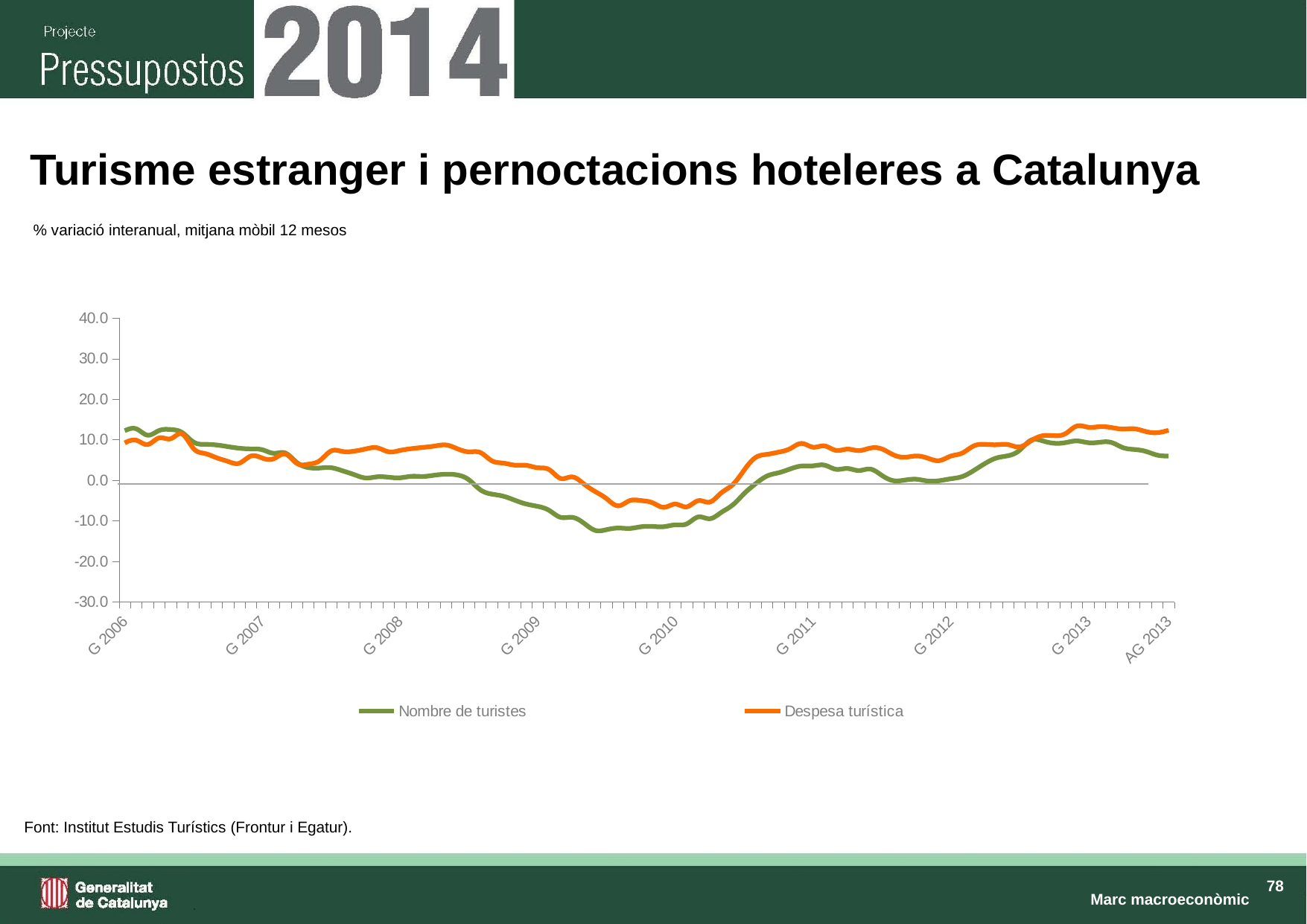
What kind of chart is shown on the slide? line chart Is the value for Despesa turística at G 2010 greater or less than 0.0? less How many series does the legend list? 2 What are the two series named in the legend? Nombre de turistes and Despesa turística Which series reaches the lowest value on the chart? Nombre de turistes At G 2006, which series has the higher value, Nombre de turistes or Despesa turística? Nombre de turistes Is the value for Despesa turística at G 2013 greater or less than 10.0? greater What is the title of the chart on the slide? Turisme estranger i pernoctacions hoteleres a Catalunya Does the Nombre de turistes series rise or fall between G 2008 and G 2010? fall Is the value for Nombre de turistes at G 2006 greater or less than 10.0? greater At G 2010, which series has the higher value, Nombre de turistes or Despesa turística? Despesa turística